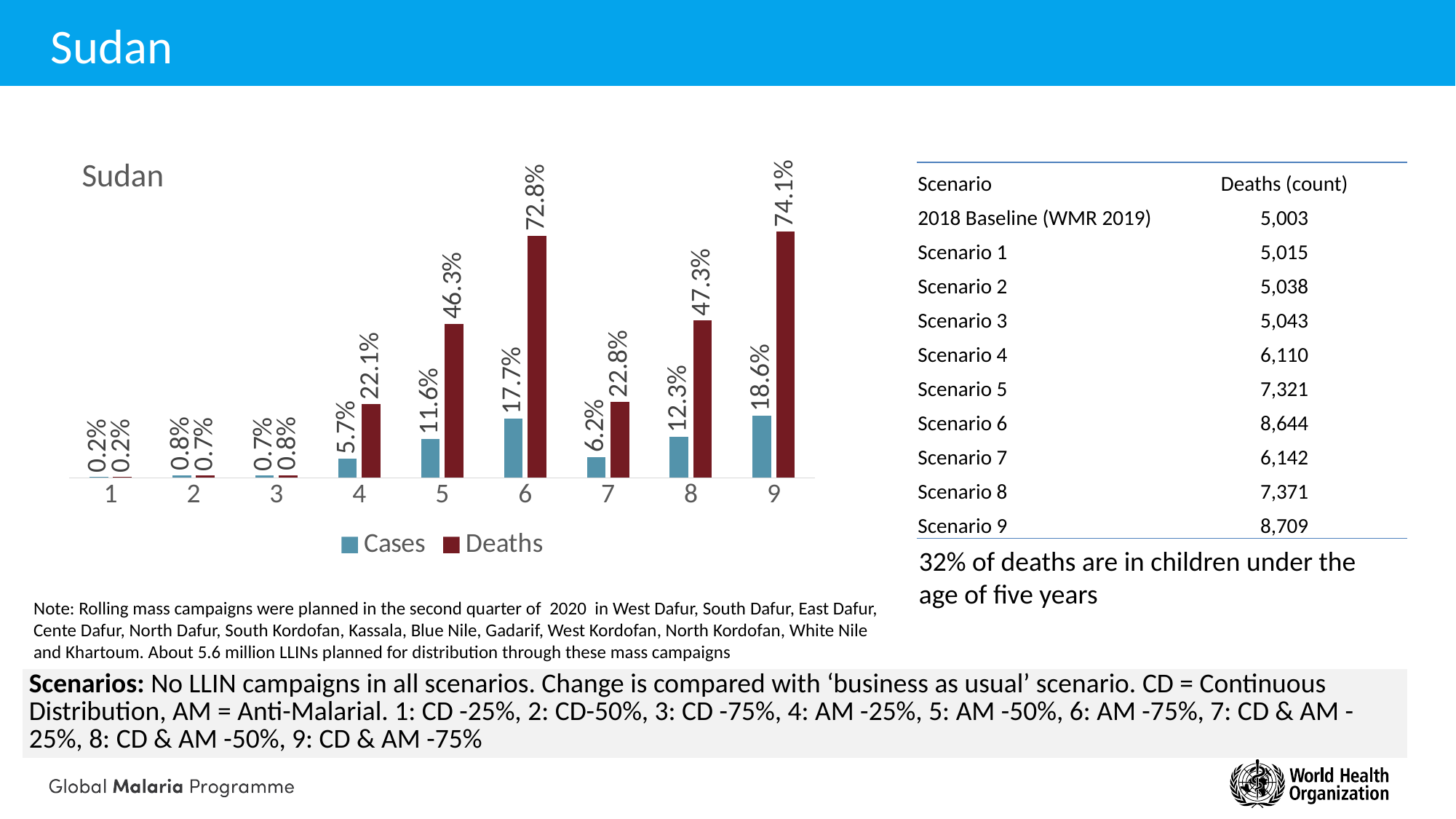
What is the Cases value for scenario 4 in the Sudan chart? 5.7% What is the difference between the Deaths values for scenario 9 and scenario 6 in the Sudan chart? 1.3% In the Sudan chart, is the Deaths value for scenario 8 larger than the Deaths value for scenario 7? Yes What is the difference between the Deaths value and the Cases value for scenario 5 in the Sudan chart? 34.7% Which scenario has the highest Deaths value in the Sudan chart? 9 What kind of chart is the Sudan chart? Bar chart What is the Deaths value for scenario 6 in the Sudan chart? 72.8% What are the two series listed in the legend of the Sudan chart? Cases and Deaths How many scenarios are shown on the x axis of the Sudan chart? 9 What is the Cases value for scenario 9 in the Sudan chart? 18.6% Which scenario has the lowest Cases value in the Sudan chart? 1 How many series does the legend of the Sudan chart list? 2